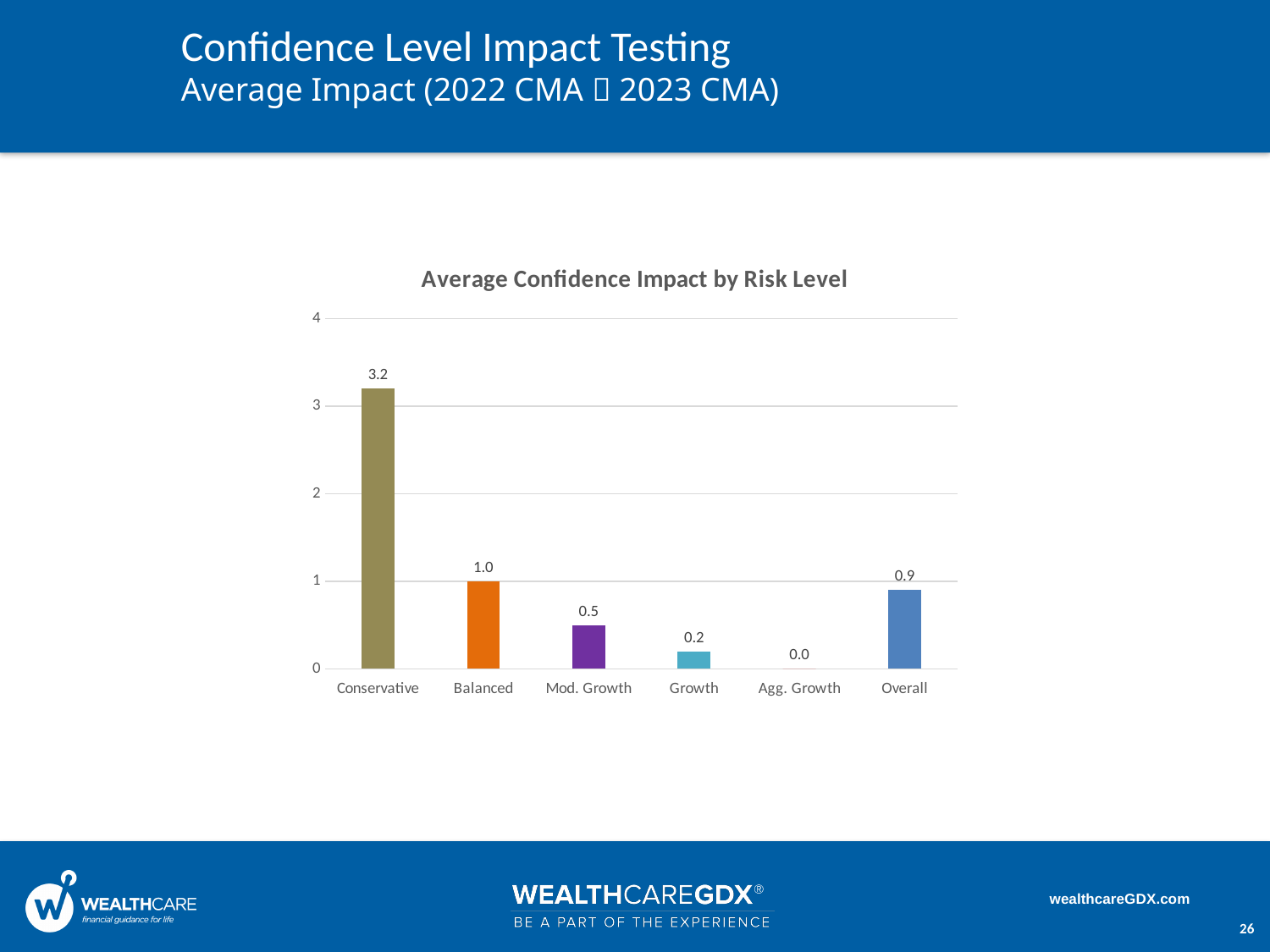
What is the value for Balanced? 1.0 Which category has the lowest value? Agg. Growth Which category has the highest value? Conservative What is the difference between the values for Conservative and Balanced? 2.2 Which is larger, the value for Growth or the value for Mod. Growth? Mod. Growth What is the value for Overall? 0.9 How many categories are shown on the x axis? 6 What is the value for Mod. Growth? 0.5 Is the value for Conservative greater or less than 3? greater What is the title of the chart? Average Confidence Impact by Risk Level What is the value for Conservative? 3.2 What kind of chart is shown? bar chart